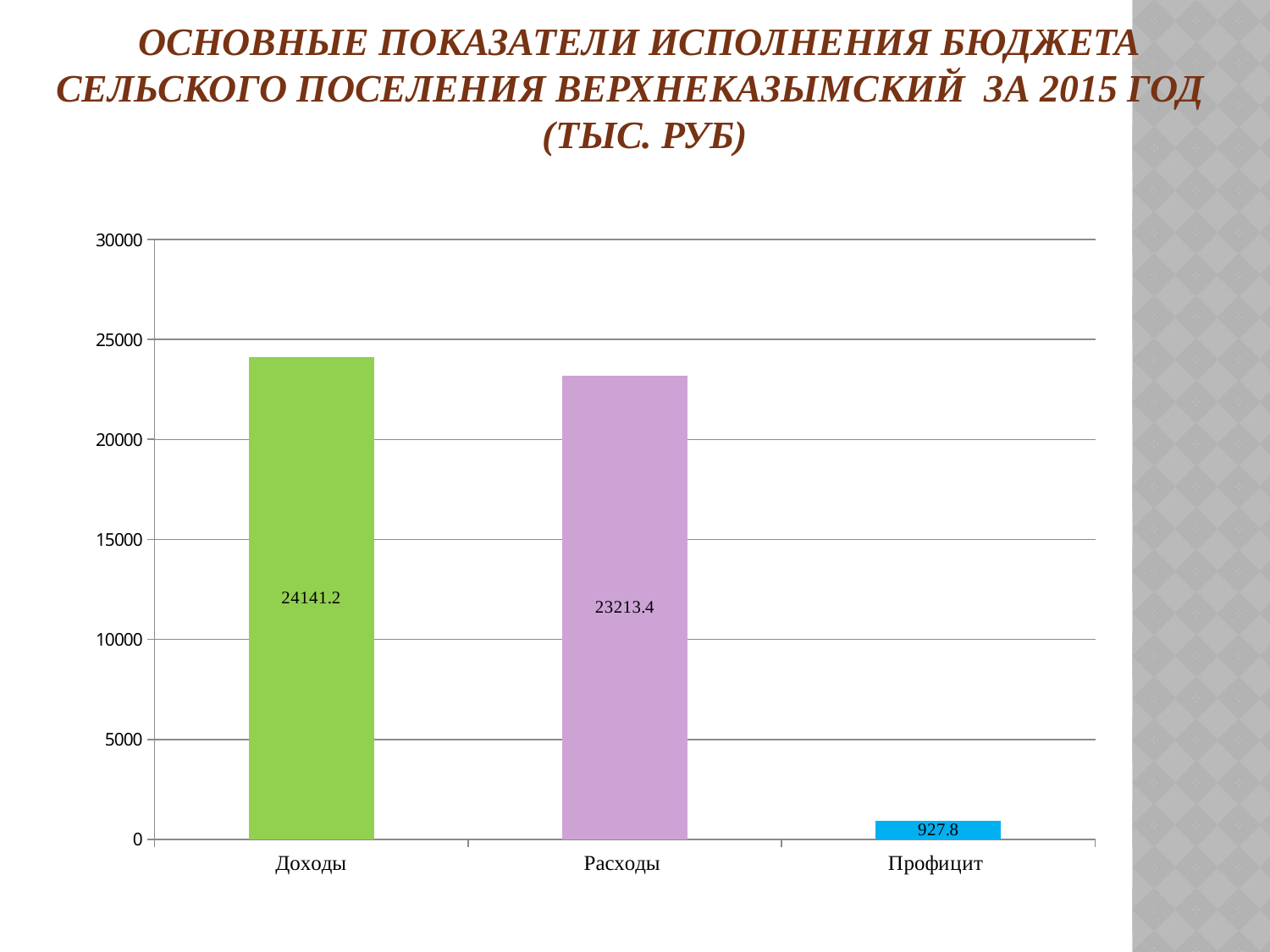
What kind of chart is shown on the slide? bar chart How many categories are shown on the x axis? 3 Which category has the lowest value? Профицит What is the value for Расходы? 23213.4 What is the value for Доходы? 24141.2 What is the value for Профицит? 927.8 Which is larger, Расходы or Профицит? Расходы Which category has the highest value? Доходы Is the value for Доходы greater or less than 20000? greater What colour is the bar for Доходы? green Is the value for Профицит greater or less than 5000? less What is the difference between Доходы and Расходы? 927.8